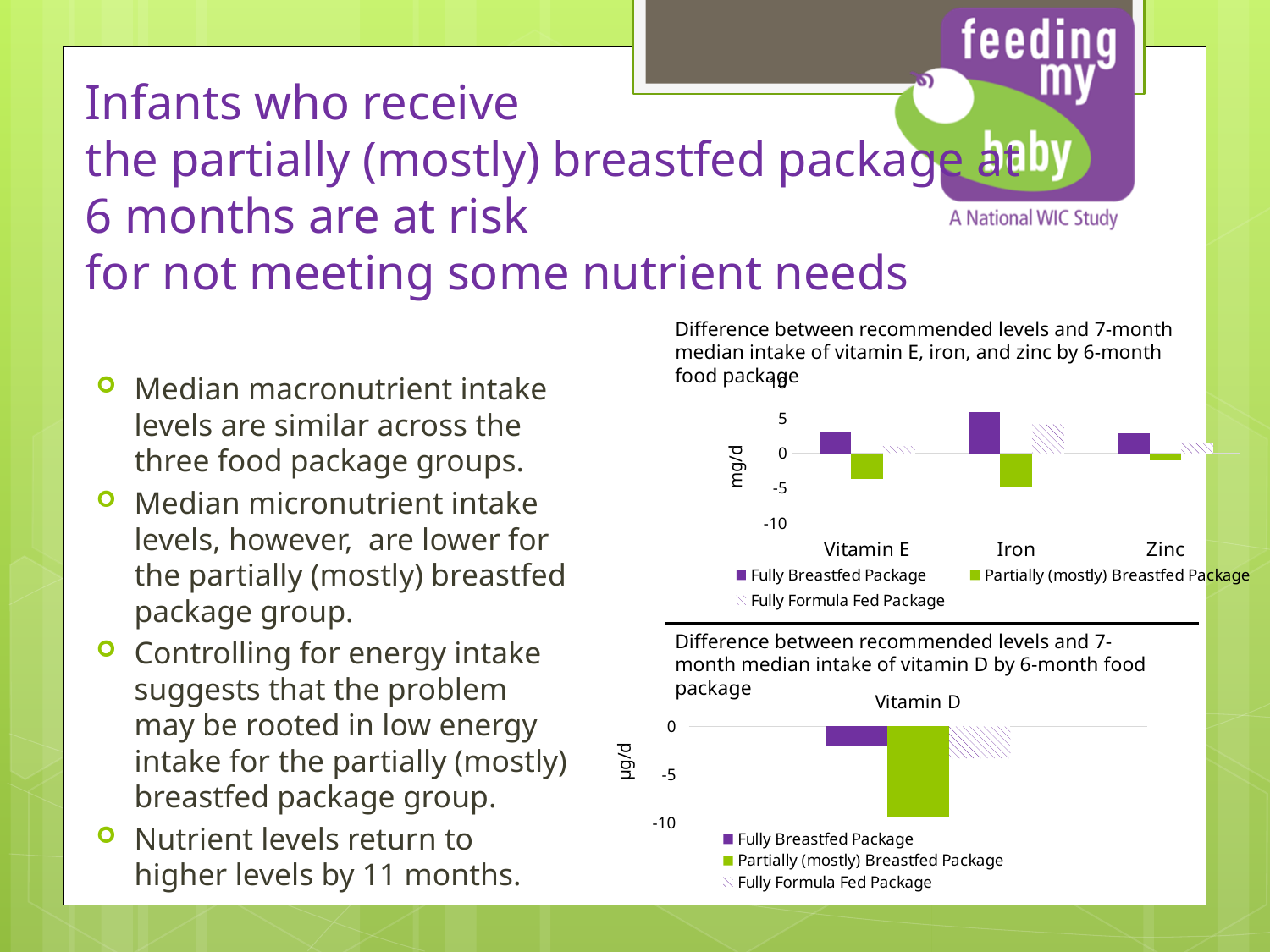
In the bottom chart (vitamin D), is the Fully Breastfed Package value greater or less than -5? greater In the top chart (vitamin E, iron, and zinc), which category has the highest value for the Fully Breastfed Package? Iron What unit is shown on the y axis of the bottom chart (vitamin D)? µg/d What unit is shown on the y axis of the top chart (vitamin E, iron, and zinc)? mg/d In the top chart (vitamin E, iron, and zinc), is the Partially (mostly) Breastfed Package value for Iron greater or less than 0? less What kind of chart is the top chart, 'Difference between recommended levels and 7-month median intake of vitamin E, iron, and zinc by 6-month food package'? Bar chart In the bottom chart (vitamin D), which series has the lowest value? Partially (mostly) Breastfed Package In the top chart (vitamin E, iron, and zinc), for Iron, which is larger: the Fully Breastfed Package value or the Partially (mostly) Breastfed Package value? Fully Breastfed Package How many series does the legend of the top chart (vitamin E, iron, and zinc) list? 3 How many categories are shown on the x axis of the top chart (vitamin E, iron, and zinc)? 3 In the bottom chart (vitamin D), is the Partially (mostly) Breastfed Package value greater or less than -5? less